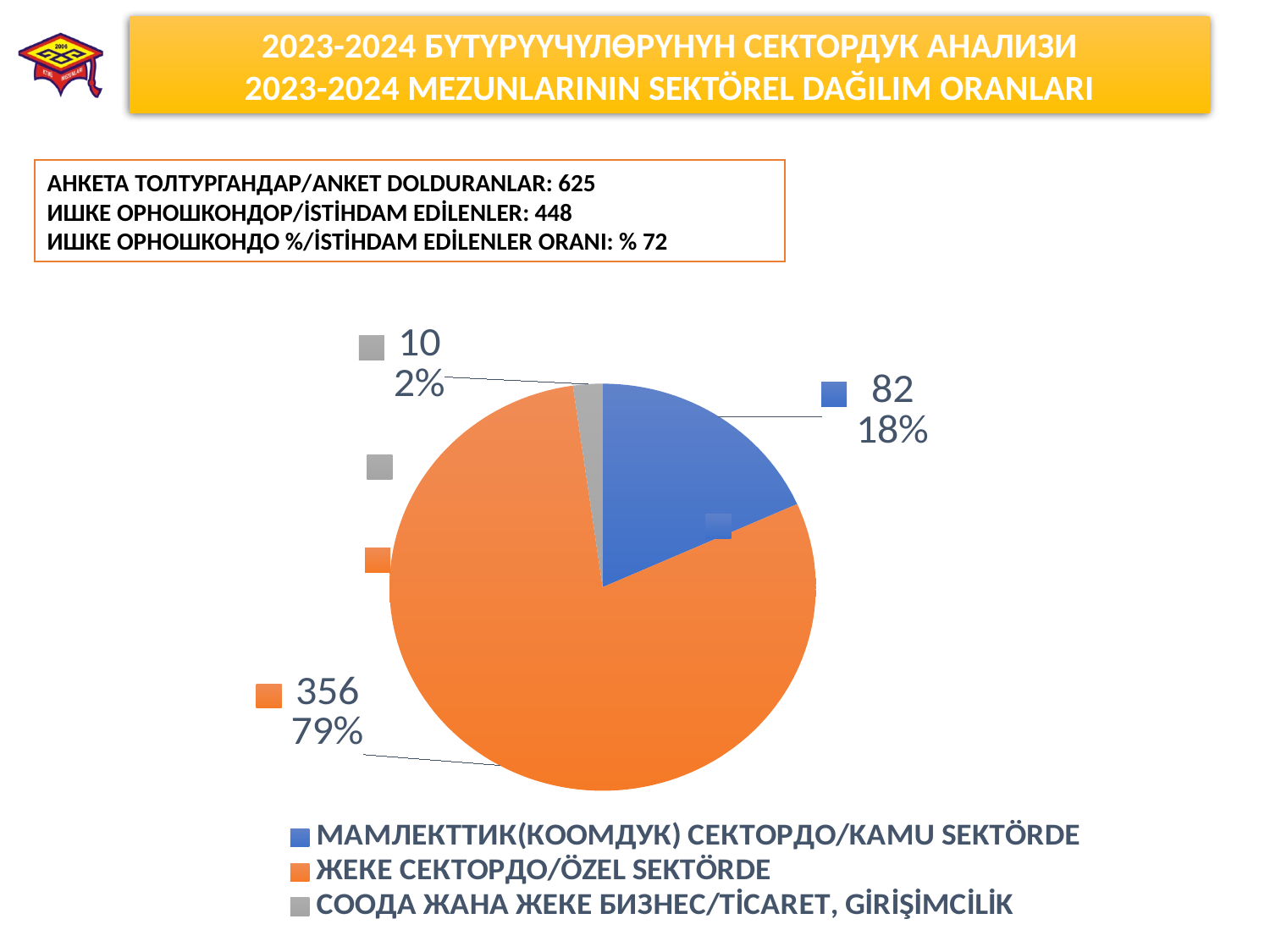
What is the value shown for ЖЕКЕ СЕКТОРДО/ÖZEL SEKTÖRDE? 356 What share of the pie does МАМЛЕКТТИК(КООМДУК) СЕКТОРДО/KAMU SEKTÖRDE represent? 18% What share of the pie does ЖЕКЕ СЕКТОРДО/ÖZEL SEKTÖRDE represent? 79% What is the difference between the values for ЖЕКЕ СЕКТОРДО/ÖZEL SEKTÖRDE and МАМЛЕКТТИК(КООМДУК) СЕКТОРДО/KAMU SEKTÖRDE? 274 How many entries does the legend of the pie chart list? 3 Which category has the largest slice of the pie? ЖЕКЕ СЕКТОРДО/ÖZEL SEKTÖRDE Which category has the smallest slice of the pie? СООДА ЖАНА ЖЕКЕ БИЗНЕС/TİCARET, GİRİŞİMCİLİK What kind of chart is shown on the slide? pie chart How many slices does the pie chart have? 3 What is the value shown for СООДА ЖАНА ЖЕКЕ БИЗНЕС/TİCARET, GİRİŞİMCİLİK? 10 Which colour is used for the ЖЕКЕ СЕКТОРДО/ÖZEL SEKTÖRDE slice? orange What is the value shown for МАМЛЕКТТИК(КООМДУК) СЕКТОРДО/KAMU SEKTÖRDE? 82